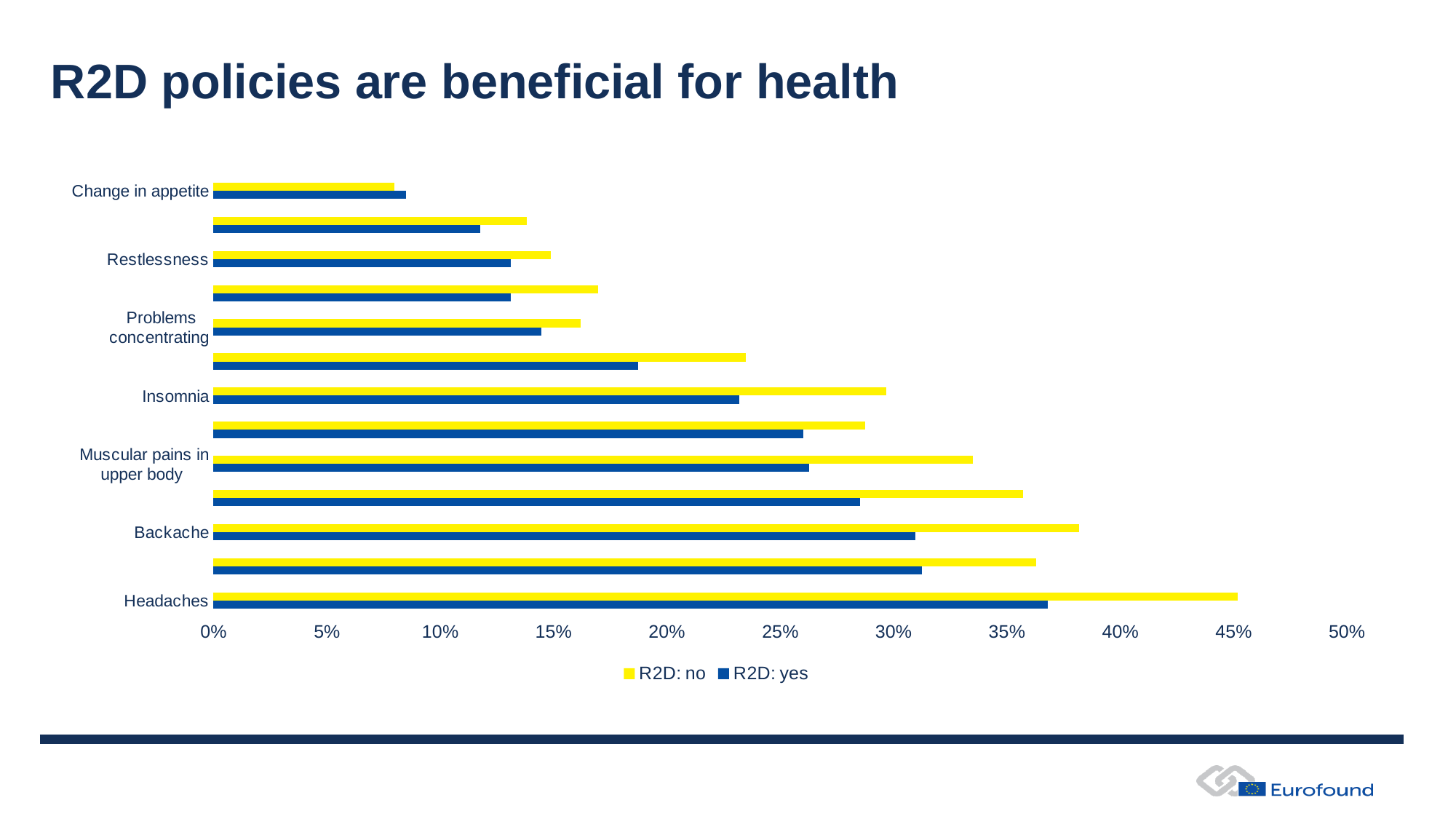
For Backache, which series has the larger value, R2D: no or R2D: yes? R2D: no How many series does the legend list? 2 Which labelled category has the lowest value for the R2D: no series? Change in appetite For Headaches, which series has the larger value, R2D: no or R2D: yes? R2D: no Is the R2D: no value for Insomnia greater or less than 25%? greater Is the R2D: no value for Change in appetite greater or less than 10%? less Is the R2D: no value for Headaches greater or less than 40%? greater What kind of chart is shown on the slide? bar chart Which colour represents the R2D: yes series in the legend? blue Which category has the highest value for the R2D: no series? Headaches